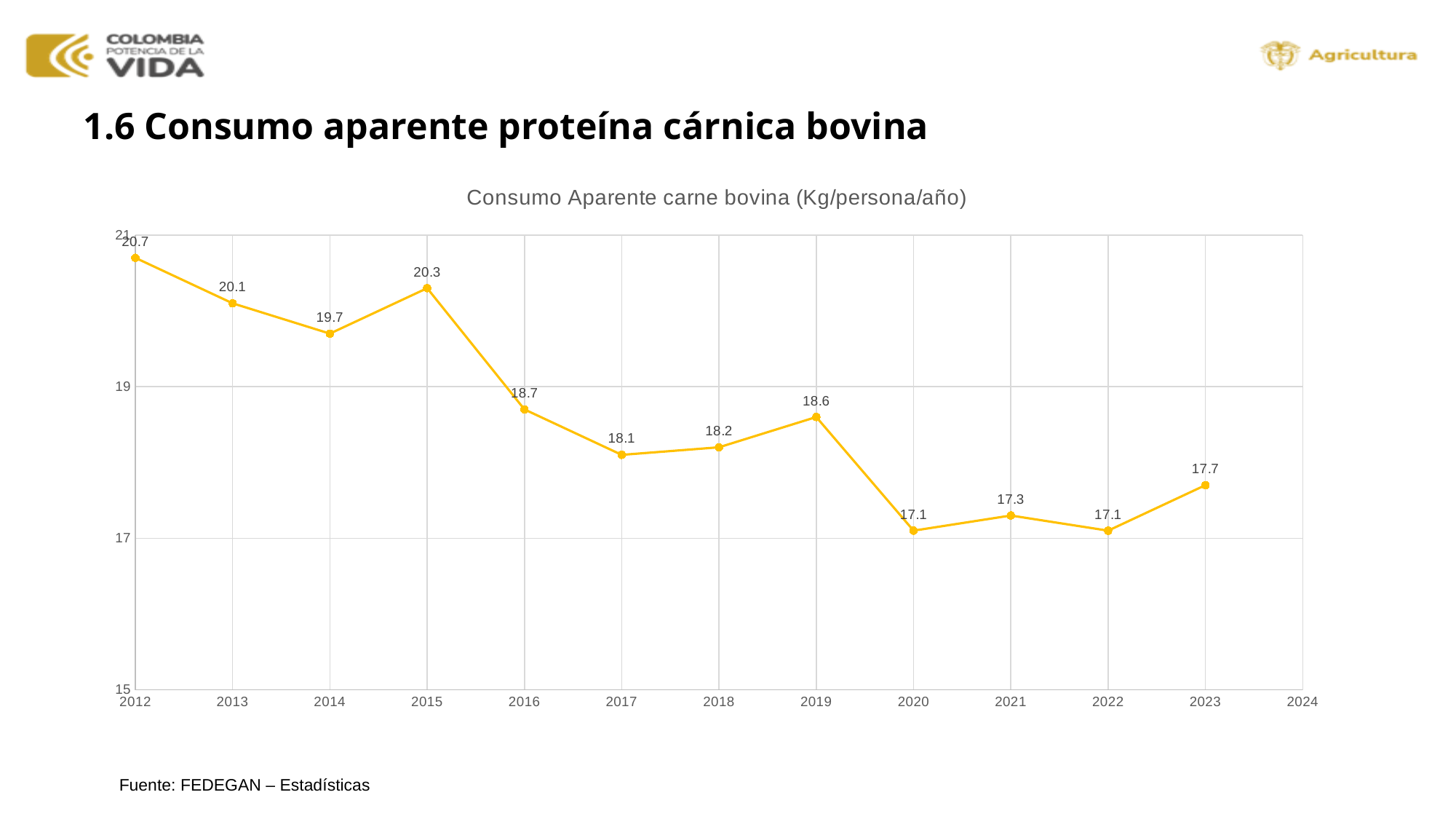
What kind of chart is shown? line chart What is the title of the chart? Consumo Aparente carne bovina (Kg/persona/año) Which is larger, the value for 2018 or the value for 2021? 2018 Which year has the highest value? 2012 What is the value for 2023? 17.7 What is the difference between the values for 2015 and 2016? 1.6 What is the value for 2012? 20.7 What is the value for 2019? 18.6 Is the value for 2017 greater or less than 19? less How many data points are plotted on the chart? 12 What is the difference between the values for 2012 and 2023? 3.0 What is the lowest value plotted on the chart? 17.1